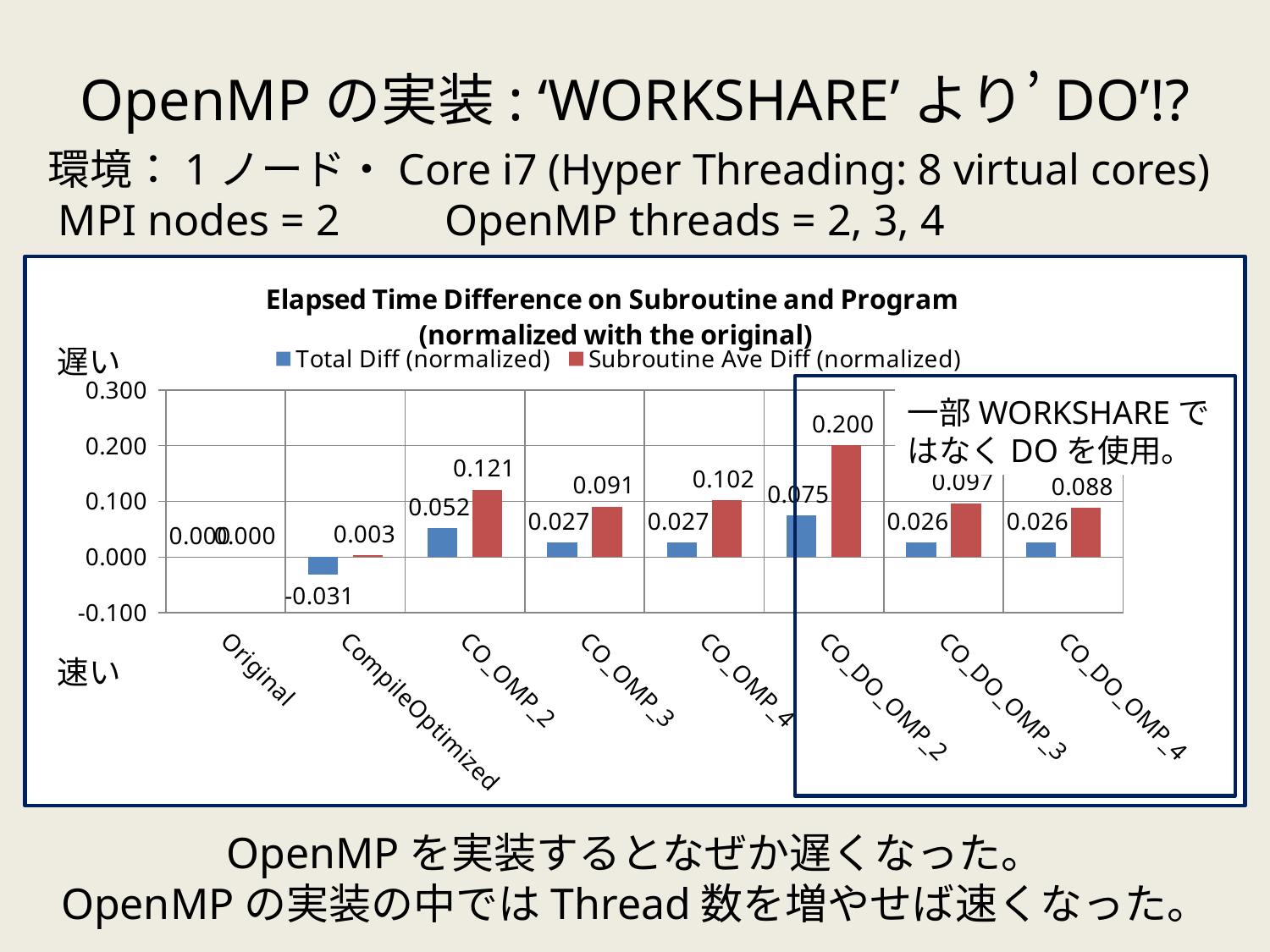
What is the difference between the Subroutine Ave Diff values for CO_DO_OMP_2 and CO_DO_OMP_3? 0.103 What kind of chart is shown on the slide? Bar chart How many categories are shown on the x axis of the chart? 8 Which category has the lowest Total Diff (normalized) value? CompileOptimized Which has the larger Subroutine Ave Diff (normalized) value, CO_OMP_3 or CO_OMP_4? CO_OMP_4 What is the Total Diff (normalized) value for CompileOptimized? -0.031 What is the Total Diff (normalized) value for CO_DO_OMP_2? 0.075 How many series does the chart legend list? 2 What is the difference between the Subroutine Ave Diff and the Total Diff values for CO_OMP_2? 0.069 Which category has the highest Subroutine Ave Diff (normalized) value? CO_DO_OMP_2 Which category has the highest Total Diff (normalized) value? CO_DO_OMP_2 What is the Subroutine Ave Diff (normalized) value for CO_DO_OMP_2? 0.200